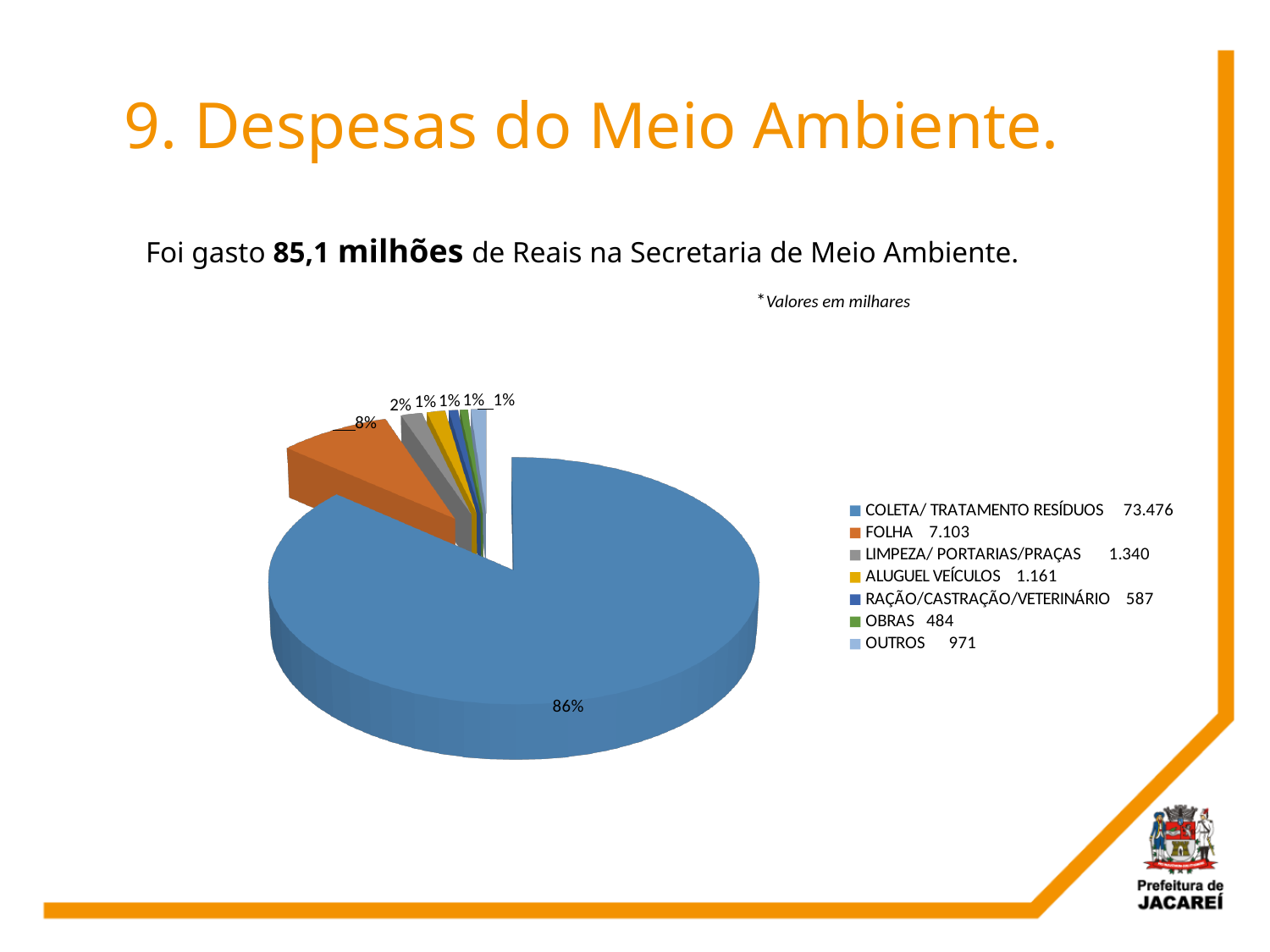
What share of the pie does FOLHA represent? 8% What is the value for COLETA/ TRATAMENTO RESÍDUOS? 73.476 How many categories does the pie chart's legend list? 7 Which category has the largest value? COLETA/ TRATAMENTO RESÍDUOS What is the value for ALUGUEL VEÍCULOS? 1.161 Which category has the smallest value? OBRAS What kind of chart is shown on the slide? pie chart Which is larger, the value for RAÇÃO/CASTRAÇÃO/VETERINÁRIO or the value for OUTROS? OUTROS What is the value for OUTROS? 971 What is the value for FOLHA? 7.103 What is the difference between the values for LIMPEZA/ PORTARIAS/PRAÇAS and ALUGUEL VEÍCULOS? 179 What share of the pie does COLETA/ TRATAMENTO RESÍDUOS represent? 86%